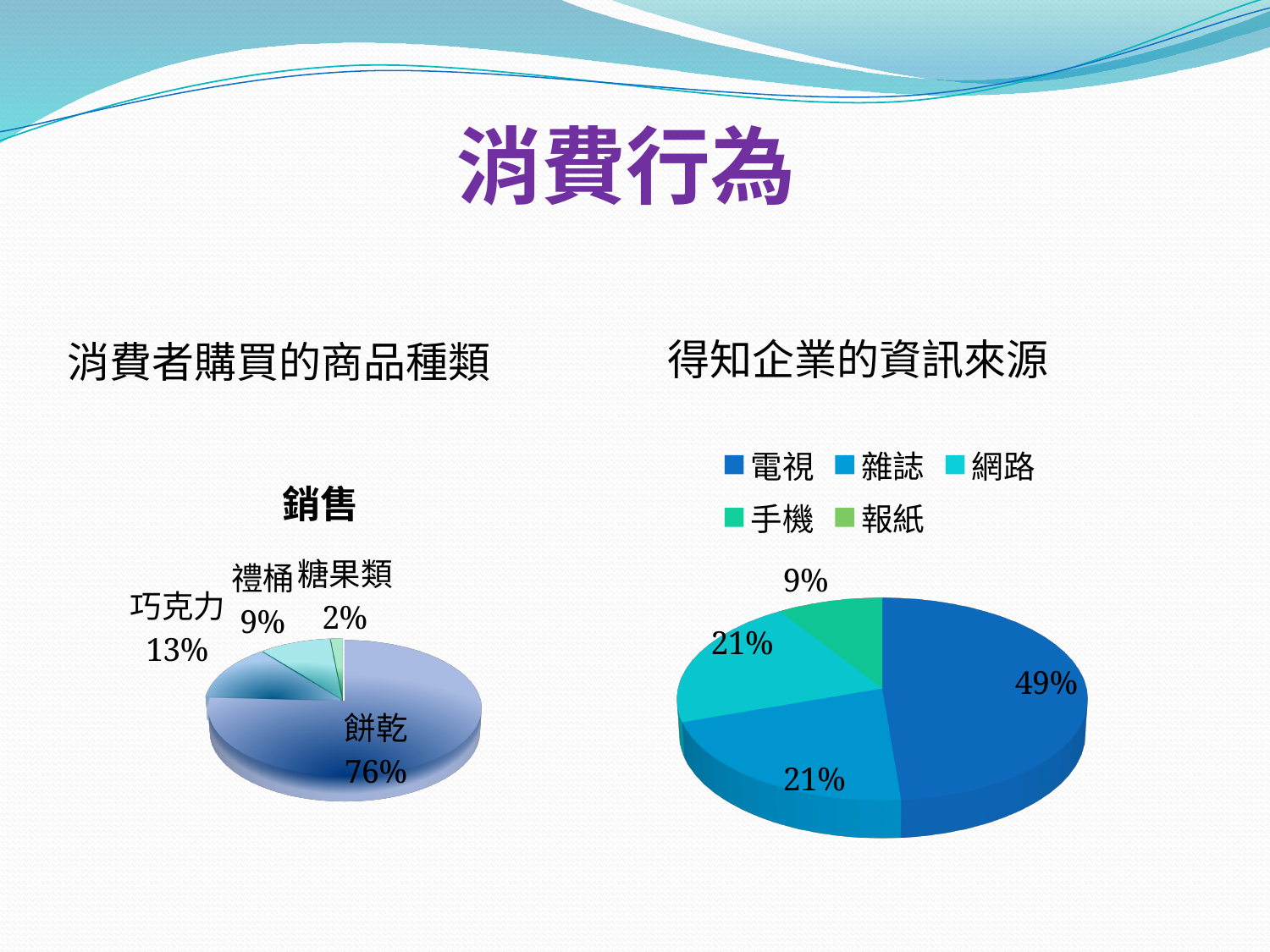
On the left chart titled 銷售, how many categories are shown? 4 On the left chart titled 銷售, what percentage is 餅乾? 76% On the left chart titled 銷售, what is the difference between the shares of 巧克力 and 禮桶? 4% On the left chart titled 銷售, what percentage is 巧克力? 13% On the right chart (得知企業的資訊來源), which is larger, 電視 or 雜誌? 電視 On the right chart (得知企業的資訊來源), what percentage is 手機? 9% On the left chart titled 銷售, which category has the smallest share? 糖果類 On the left chart titled 銷售, which category has the largest share? 餅乾 What kind of chart is the left chart titled 銷售? pie chart On the right chart (得知企業的資訊來源), how many entries does the legend list? 5 On the right chart (得知企業的資訊來源), which source has the largest share? 電視 On the right chart (得知企業的資訊來源), what percentage is 電視? 49%